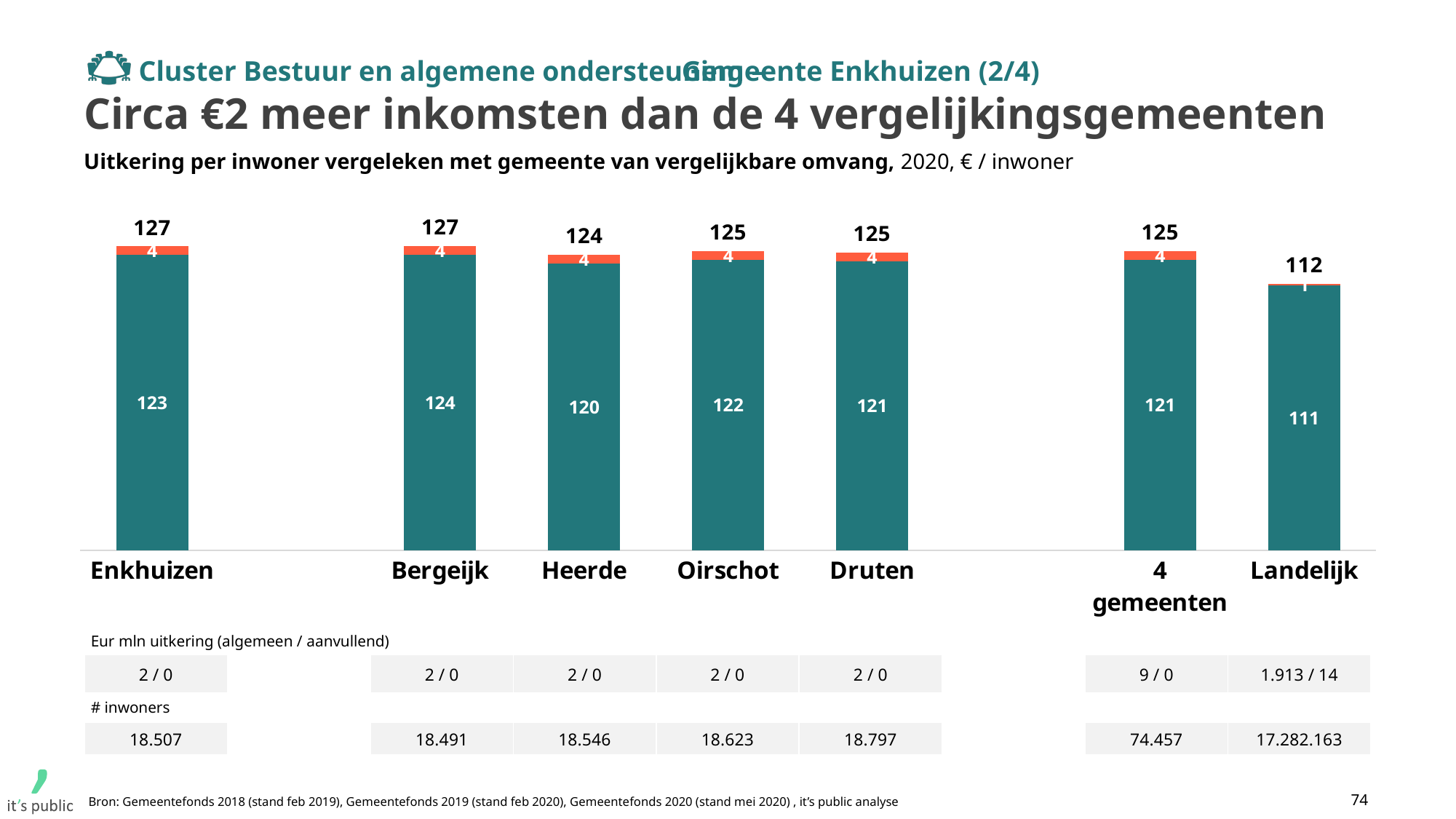
What is the value of the orange (upper) segment for Druten? 4 Which category has the lowest total value? Landelijk What is the total value shown above the bar for Enkhuizen? 127 What is the total value shown above the bar for Landelijk? 112 What kind of chart is shown on the slide? Stacked bar chart What is the difference between the teal segment for Bergeijk and the teal segment for Heerde? 4 How many categories are shown on the x axis? 7 Which has a larger total value, Heerde or Oirschot? Oirschot What is the value of the teal (lower) segment for Heerde? 120 What is the value of the teal (lower) segment for 4 gemeenten? 121 What is the difference between the total for Enkhuizen and the total for 4 gemeenten? 2 What is the number of inhabitants (# inwoners) listed for Enkhuizen below the chart? 18.507